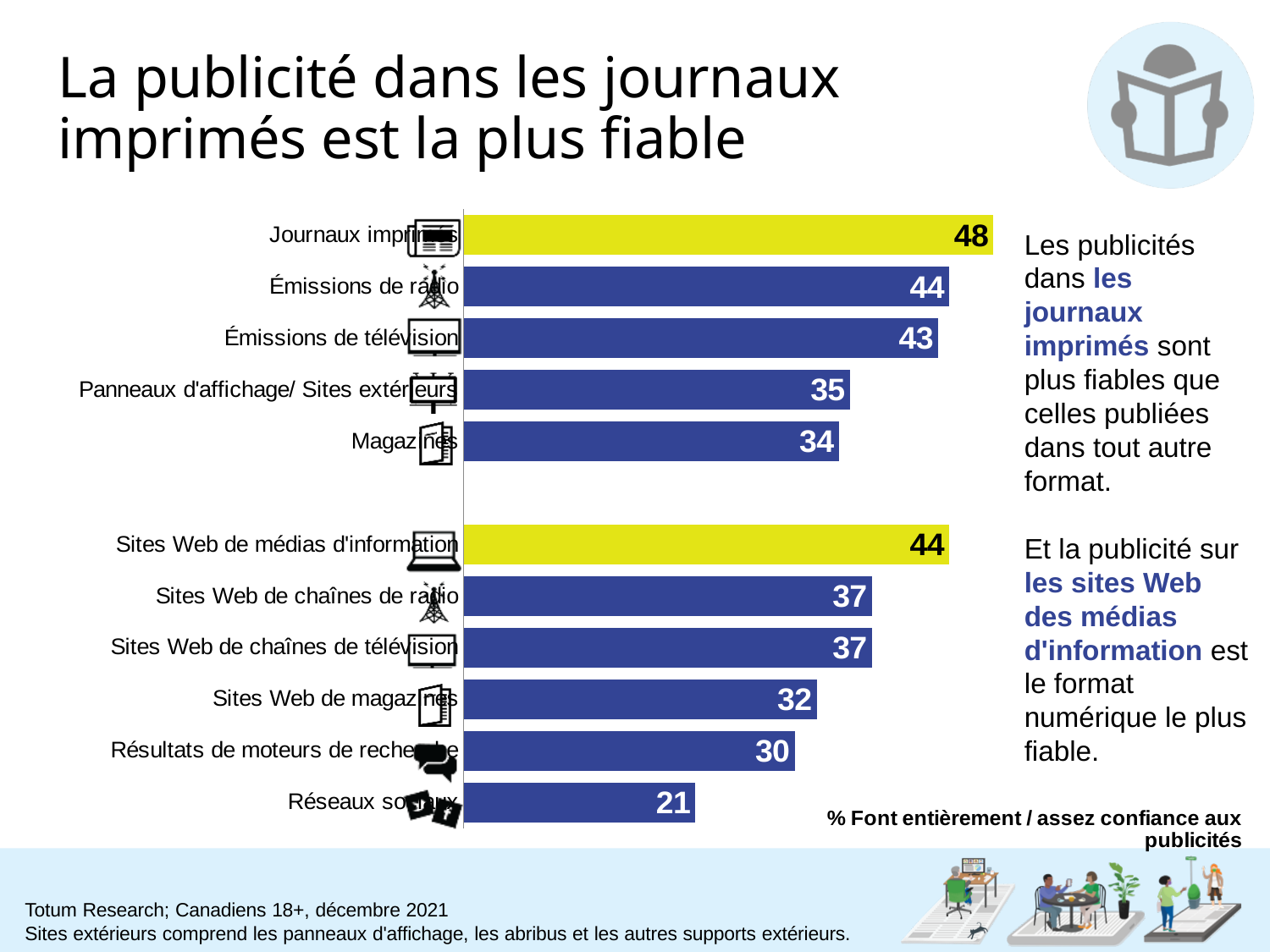
What is the value for Résultats de moteurs de recherche? 30 What kind of chart is shown on the slide? Bar chart What is the value for Sites Web de médias d'information? 44 What is the difference between the values for Émissions de télévision and Sites Web de chaînes de télévision? 6 What is the difference between the values for Journaux imprimés and Réseaux sociaux? 27 What is the value for Panneaux d'affichage/ Sites extérieurs? 35 Which category has the highest value? Journaux imprimés Which category has the lowest value? Réseaux sociaux Which is larger, the value for Magazines or the value for Sites Web de magazines? Magazines How many categories are shown in the chart? 11 What is the value for Journaux imprimés? 48 Which two bars are highlighted in yellow? Journaux imprimés and Sites Web de médias d'information